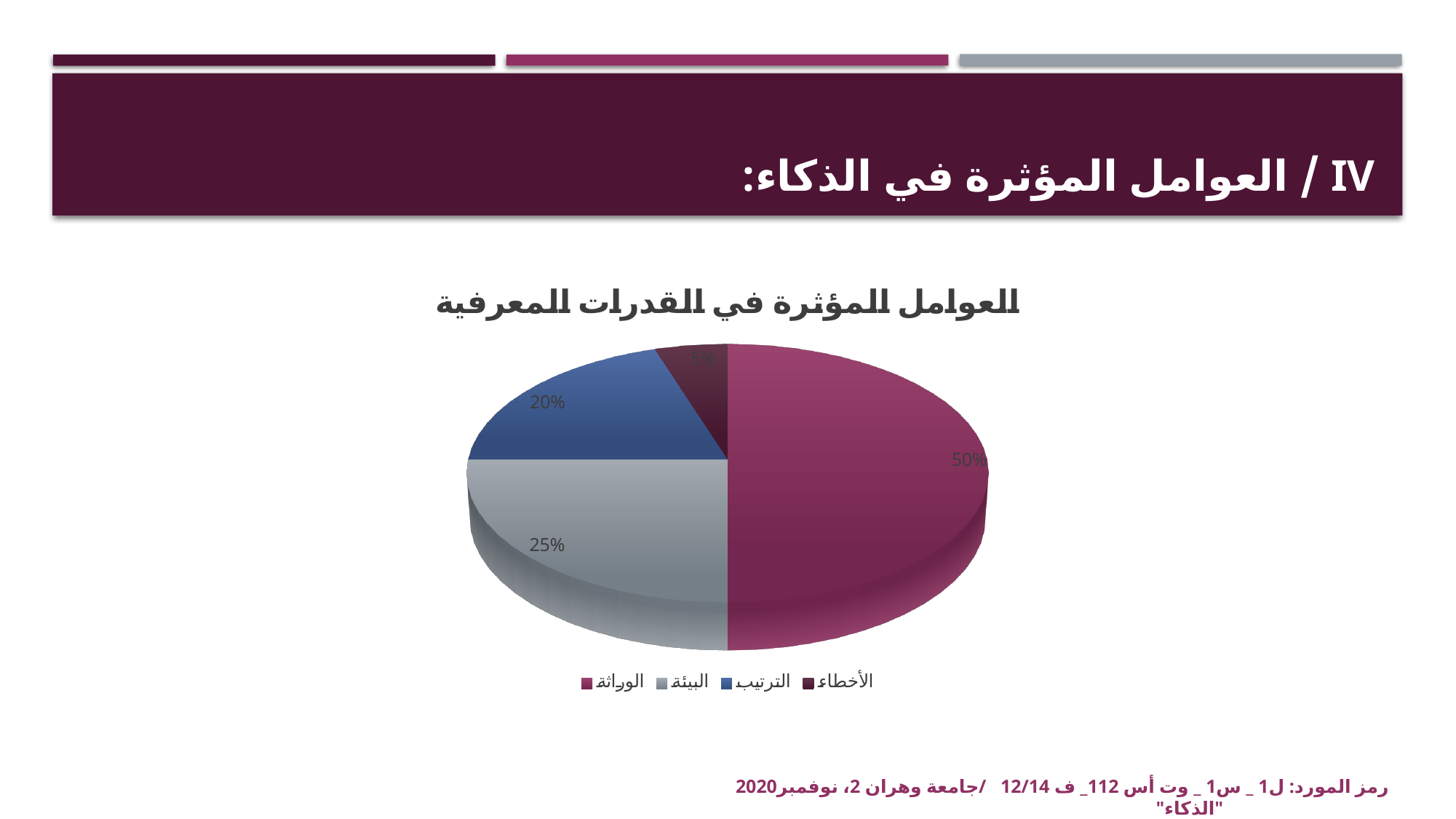
How many categories does the legend list? 4 Which is larger, the share for البيئة or the share for الترتيب? البيئة What percentage does the الترتيب slice represent? 20% What percentage does the الوراثة slice represent? 50% What percentage does the الأخطاء slice represent? 5% What colour is the الترتيب slice? Blue What kind of chart is shown on the slide? Pie chart Which category has the largest share of the pie? الوراثة Which category has the smallest share of the pie? الأخطاء What percentage does the البيئة slice represent? 25% What is the difference in percentage points between الوراثة and البيئة? 25 What is the title of the chart? العوامل المؤثرة في القدرات المعرفية